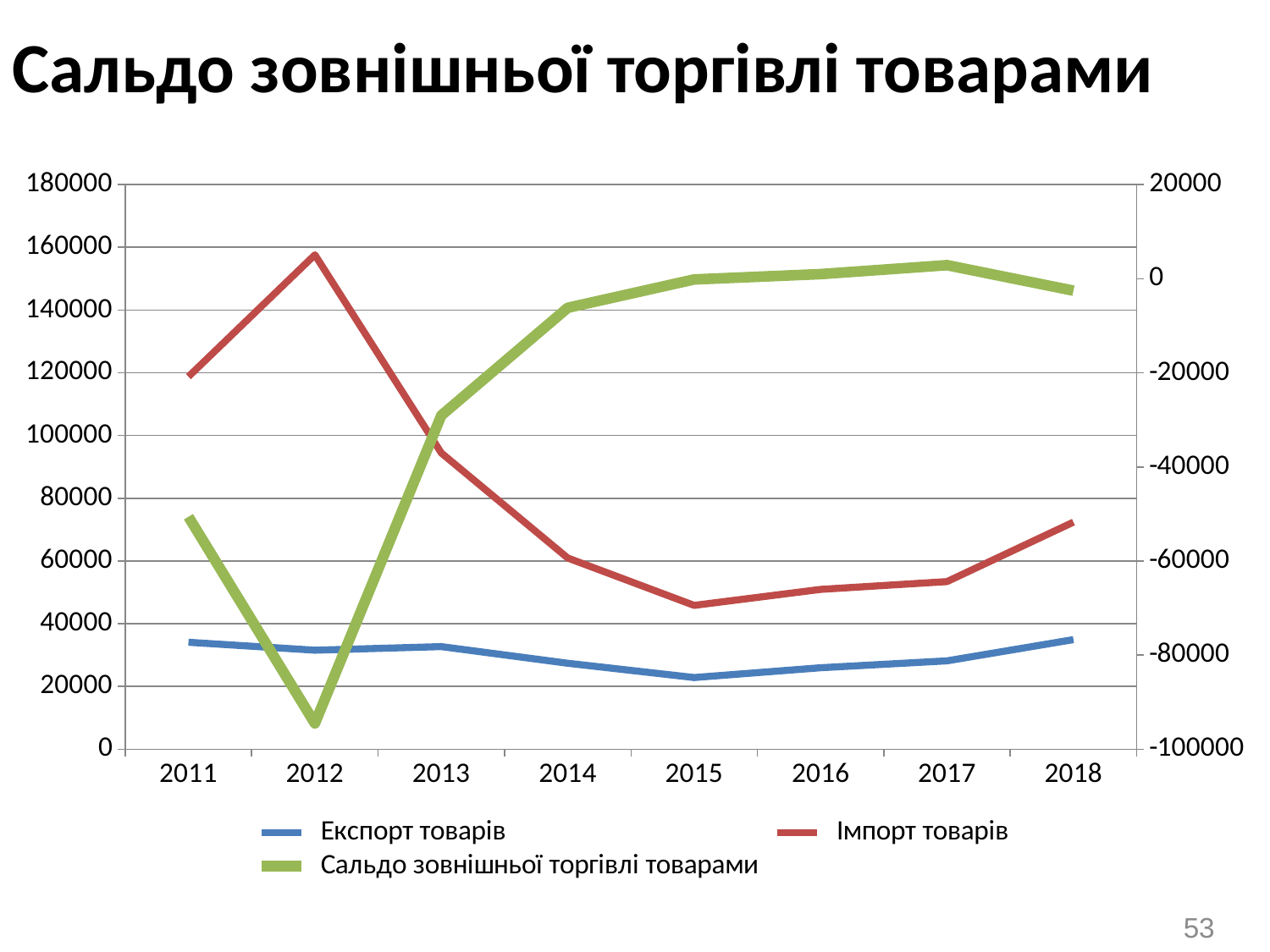
Which is larger: Імпорт товарів in 2011 or in 2013? 2011 What kind of chart is shown on the slide? line chart In which year is Імпорт товарів highest? 2012 In which year is Експорт товарів lowest? 2015 How many years are plotted along the x axis? 8 How many series does the legend list? 3 Does Імпорт товарів rise or fall from 2012 to 2015? fall In which year is Сальдо зовнішньої торгівлі товарами lowest? 2012 In which year is Імпорт товарів lowest? 2015 Is the value for Експорт товарів in 2011 greater or less than 40000? less Is the value for Імпорт товарів in 2015 greater or less than 60000? less